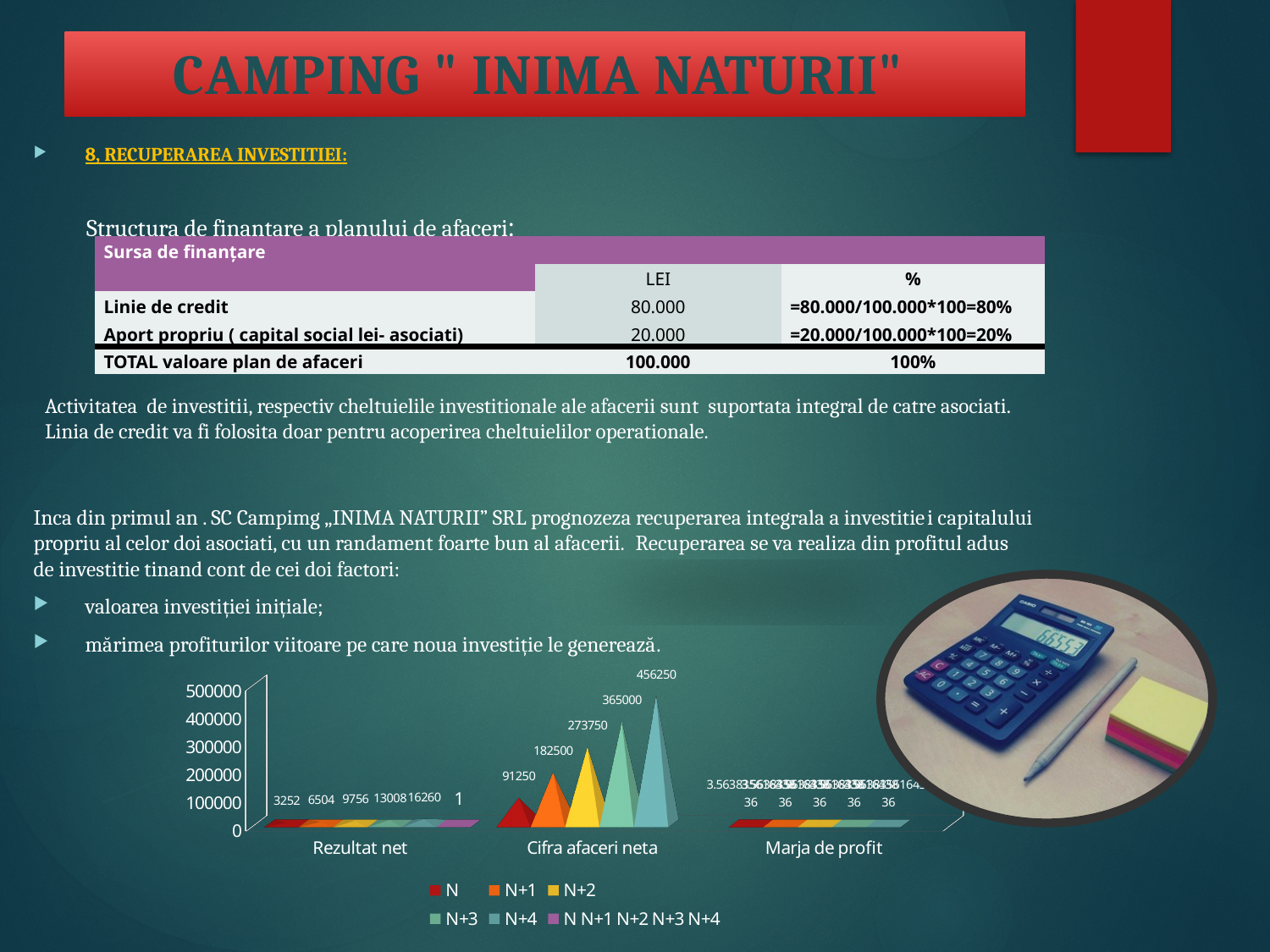
What is the value of the N series for Cifra afaceri neta? 91250 Which series has the highest value for Cifra afaceri neta? N+4 What is the difference between the N+1 and N values for Rezultat net? 3252 How many series does the chart legend list? 6 What is the difference between the N+4 and N+3 values for Cifra afaceri neta? 91250 Do the values for Cifra afaceri neta rise or fall from N to N+4? rise How many categories are shown on the x axis of the chart? 3 What is the value of the N series for Rezultat net? 3252 Which is larger: the N+2 value for Cifra afaceri neta or the N+4 value for Rezultat net? N+2 value for Cifra afaceri neta What is the value of the N+4 series for Cifra afaceri neta? 456250 What is the value of the N+4 series for Rezultat net? 16260 Is the N+4 value for Cifra afaceri neta greater or less than 400000? greater